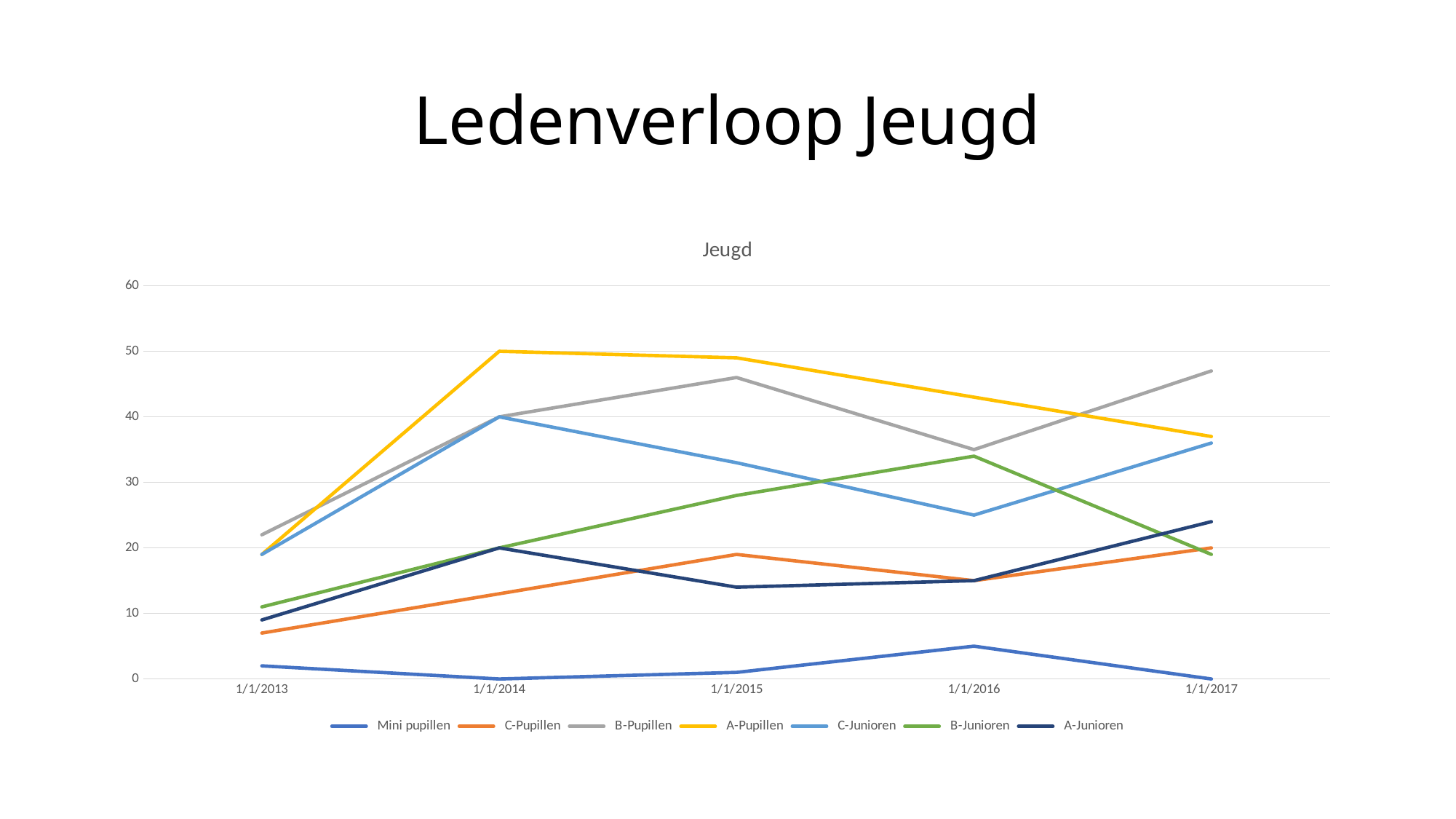
What is the value for Mini pupillen on 1/1/2017? 0 Is the value for B-Pupillen on 1/1/2017 greater or less than 40? greater What is the value for A-Junioren on 1/1/2014? 20 Which series has the highest value on 1/1/2015? A-Pupillen How many dates are shown on the x axis? 5 Which series has the lowest value on 1/1/2016? Mini pupillen On 1/1/2017, which is larger: B-Pupillen or A-Pupillen? B-Pupillen Does the A-Pupillen line rise or fall from 1/1/2014 to 1/1/2017? fall Is the value for C-Junioren on 1/1/2016 greater or less than 30? less What is the value for A-Pupillen on 1/1/2014? 50 What kind of chart is shown on the slide? line chart How many series does the legend list? 7